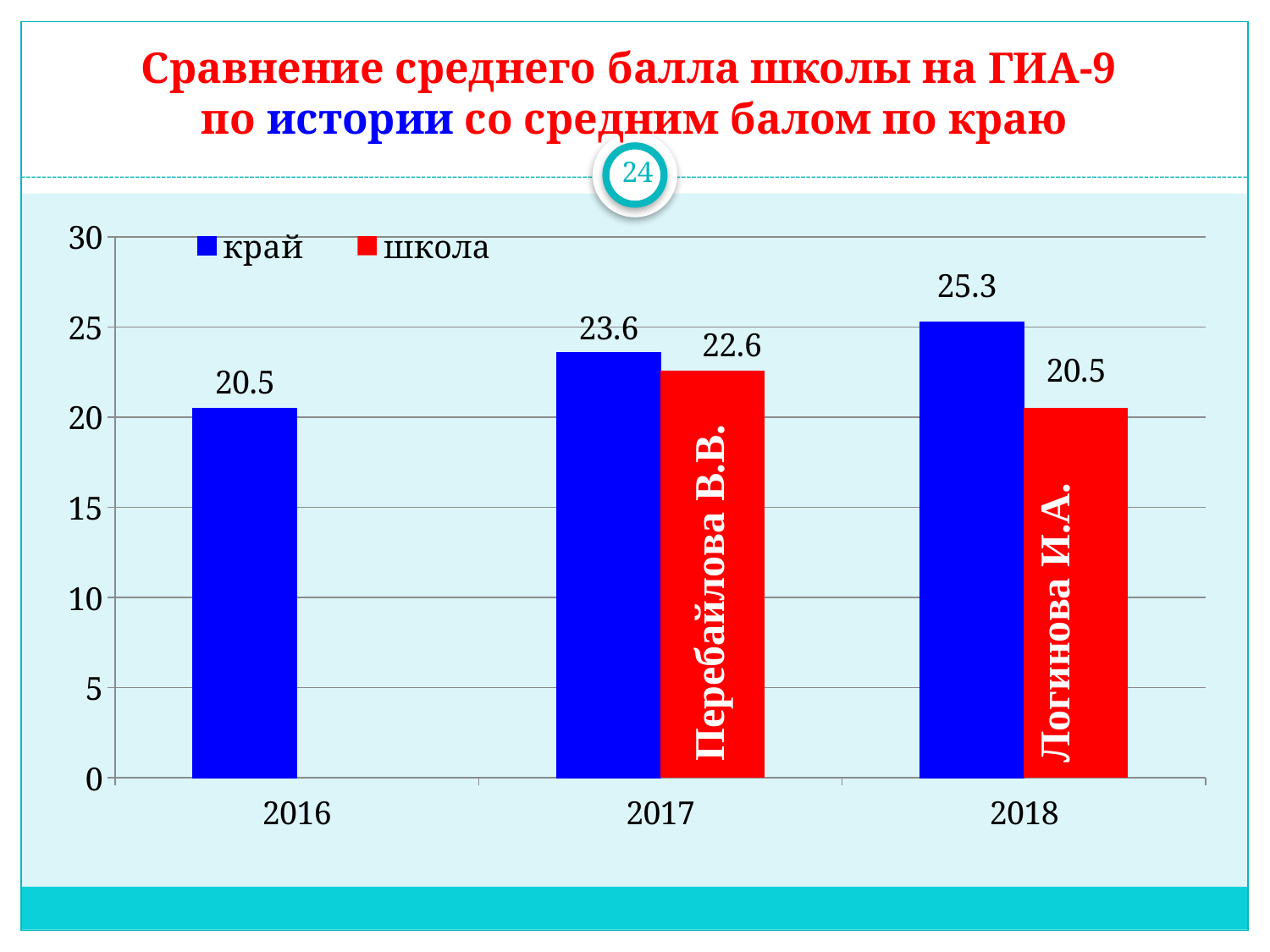
What is the value for школа in 2018? 20.5 How many series does the legend list? 2 In which year is the value for край highest? 2018 What is the value for школа in 2017? 22.6 What kind of chart is shown on the slide? bar chart What is the value for край in 2018? 25.3 Does the value for край rise or fall from 2016 to 2018? rise In which year is the value for край lowest? 2016 Which is larger in 2017, край or школа? край What is the difference between край and школа in 2018? 4.8 What is the value for край in 2016? 20.5 What is the difference between край and школа in 2017? 1.0